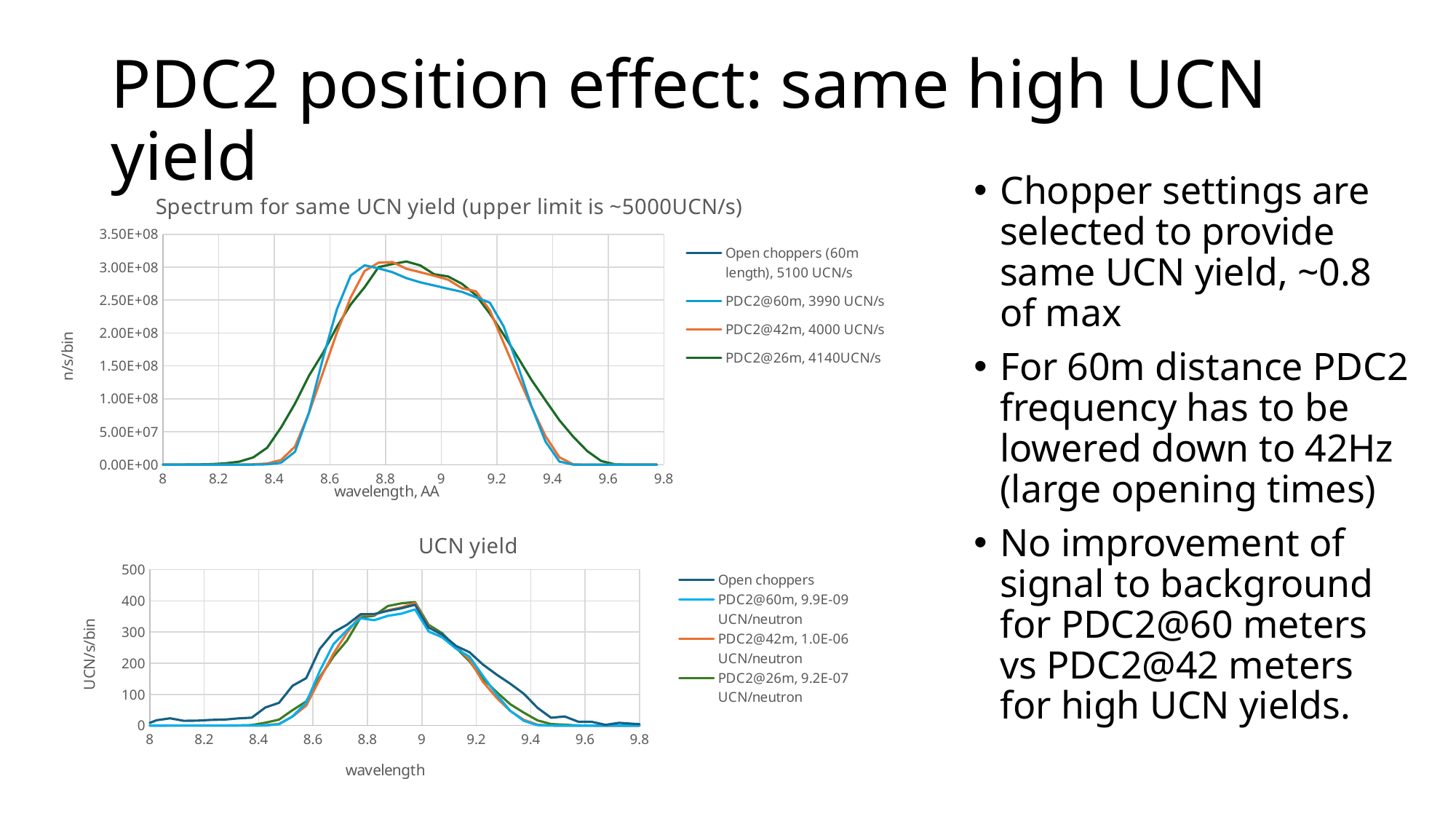
In the top chart 'Spectrum for same UCN yield', is the value for PDC2@42m at wavelength 8.2 greater or less than 5.00E+07? less In the bottom chart 'UCN yield', is the value for Open choppers at wavelength 8.8 greater or less than 300? greater What is the y-axis label of the bottom chart 'UCN yield'? UCN/s/bin What kind of chart is the top chart titled 'Spectrum for same UCN yield (upper limit is ~5000UCN/s)'? line chart In the bottom chart 'UCN yield', at wavelength 8.6, which series has the higher value: Open choppers or PDC2@26m? Open choppers In the top chart 'Spectrum for same UCN yield', is the value for PDC2@60m at wavelength 8.8 greater or less than 2.50E+08? greater What kind of chart is the bottom chart titled 'UCN yield'? line chart How many series does the legend of the top chart 'Spectrum for same UCN yield' list? 4 What is the y-axis label of the top chart 'Spectrum for same UCN yield'? n/s/bin How many series does the legend of the bottom chart 'UCN yield' list? 4